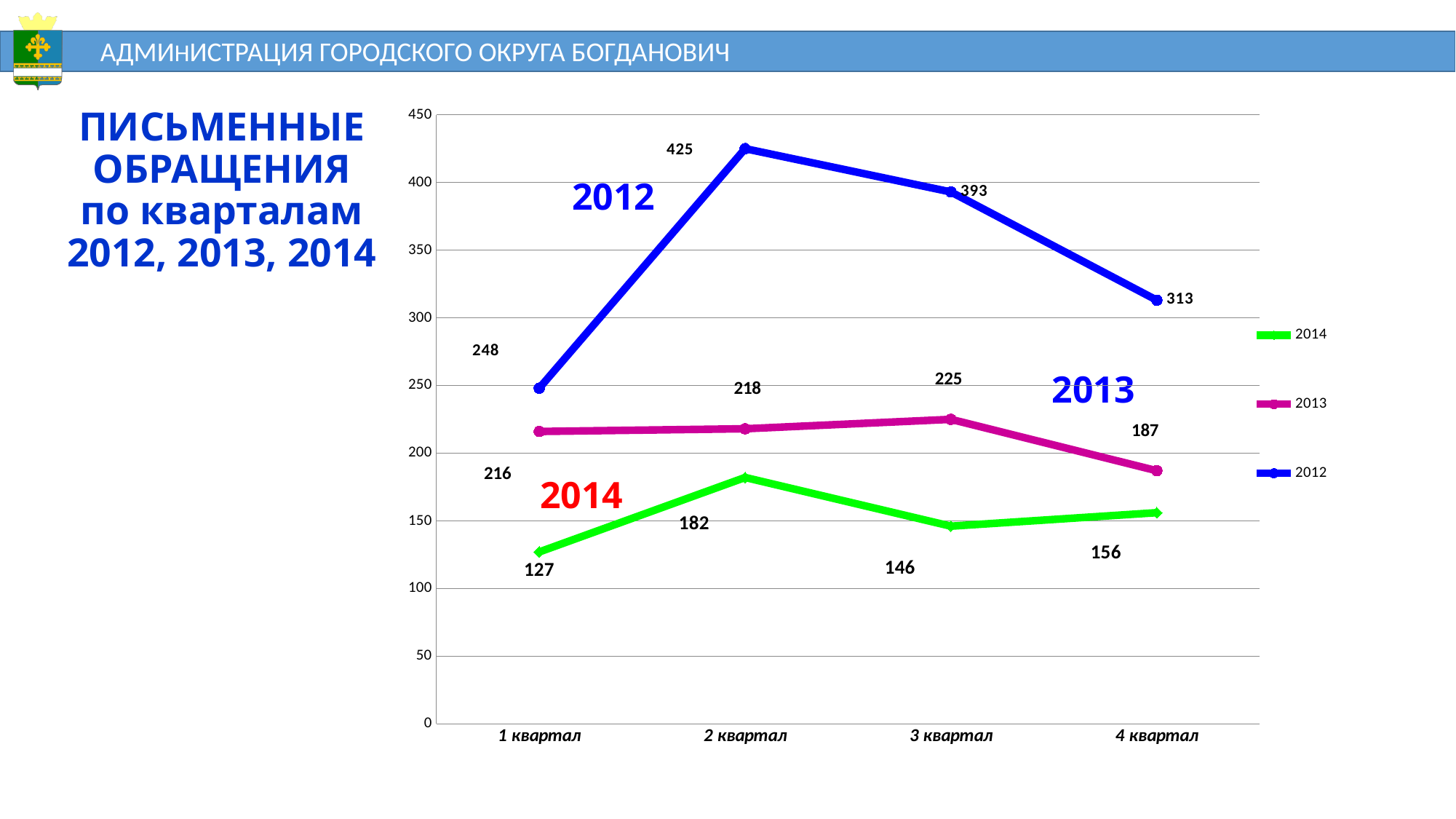
What is the value for 2013 in 4 квартал? 187 How many quarters are plotted along the x axis? 4 What is the value for 2014 in 1 квартал? 127 Which colour is used for the 2014 series? green What is the difference between the 2012 and 2014 values in 2 квартал? 243 What is the value for 2012 in 2 квартал? 425 In which quarter is the 2014 series lowest? 1 квартал Which is larger in 3 квартал: the 2013 value or the 2014 value? 2013 Does the 2012 series rise or fall from 2 квартал to 4 квартал? fall What type of chart is shown on the slide? line chart How many series does the legend list? 3 In which quarter is the 2012 series highest? 2 квартал